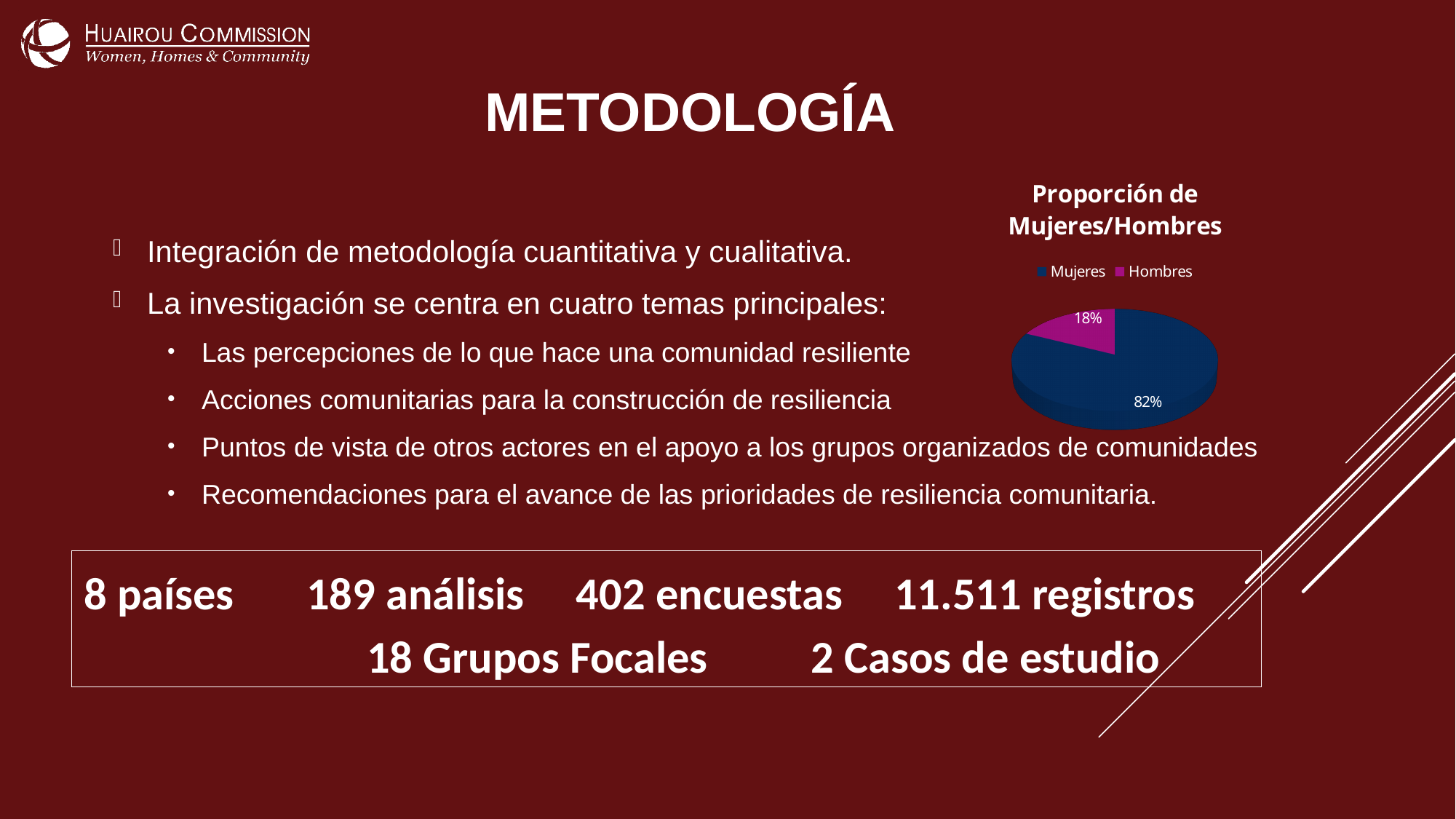
How many slices does the pie chart have? 2 What is the difference in percentage points between the Mujeres and Hombres slices? 64 How many categories does the legend list? 2 What share of the pie does Hombres represent? 18% What kind of chart is shown on the slide? Pie chart Which category has the largest slice of the pie? Mujeres What share of the pie does Mujeres represent? 82% Which category has the smallest slice of the pie? Hombres Which is larger, the Mujeres slice or the Hombres slice? Mujeres What colour is the Hombres slice in the pie chart? Purple What is the title of the chart? Proporción de Mujeres/Hombres